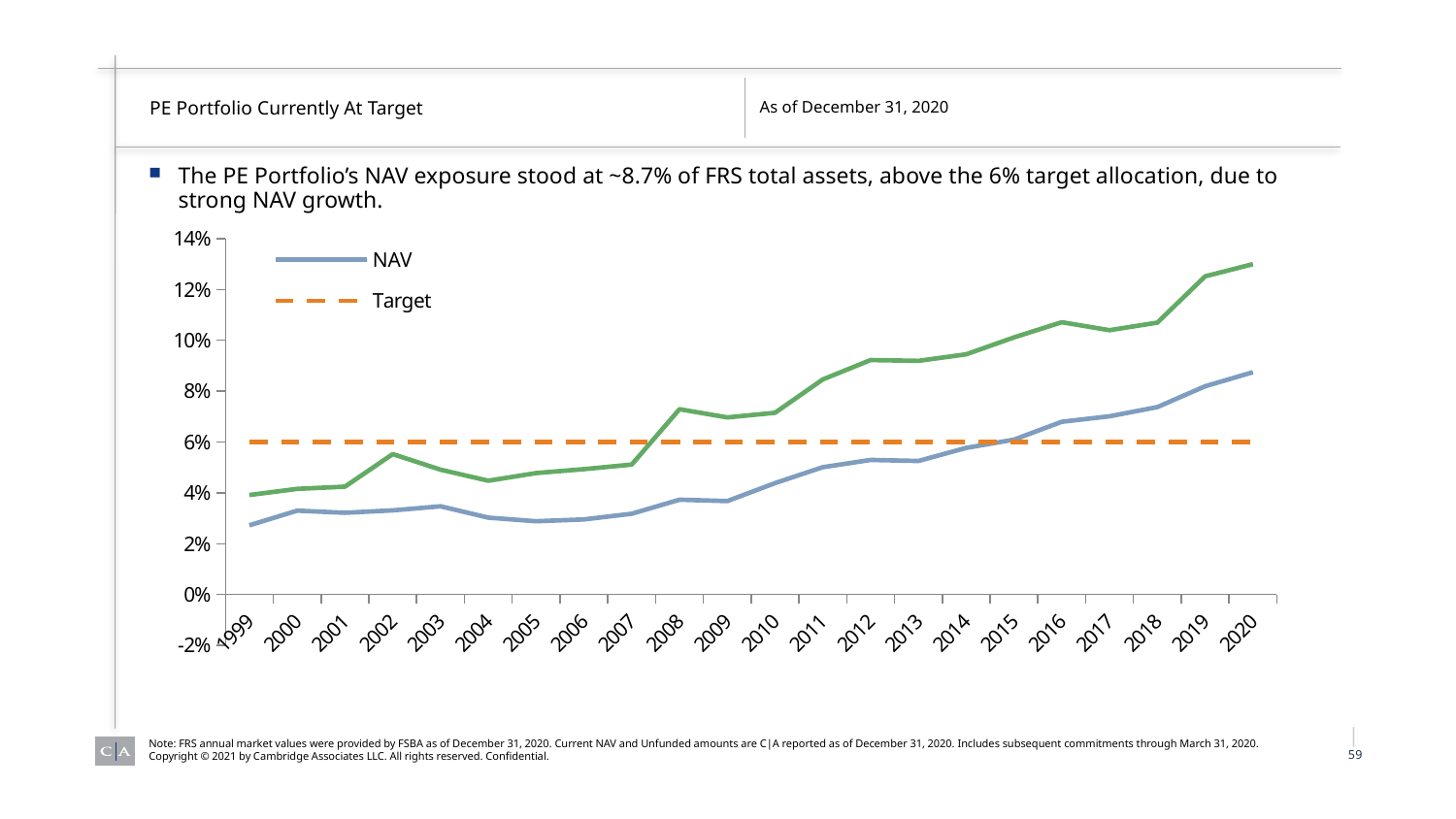
In which year does the NAV line reach its highest value? 2020 Is the NAV value for 1999 greater or less than 4%? less Is the NAV value for 2020 greater or less than 8%? greater How many series does the chart legend list? 2 What kind of chart is shown on the slide? line chart Is the NAV value for 2010 greater or less than 6%? less In 2005, which is larger, the NAV value or the Target value? Target In 2020, which is larger, the NAV value or the Target value? NAV How many years are shown along the x axis of the chart? 22 What is the value of the Target line across the years shown? 6% Does the NAV line generally rise or fall from 1999 to 2020? rise What are the two series named in the chart legend? NAV and Target